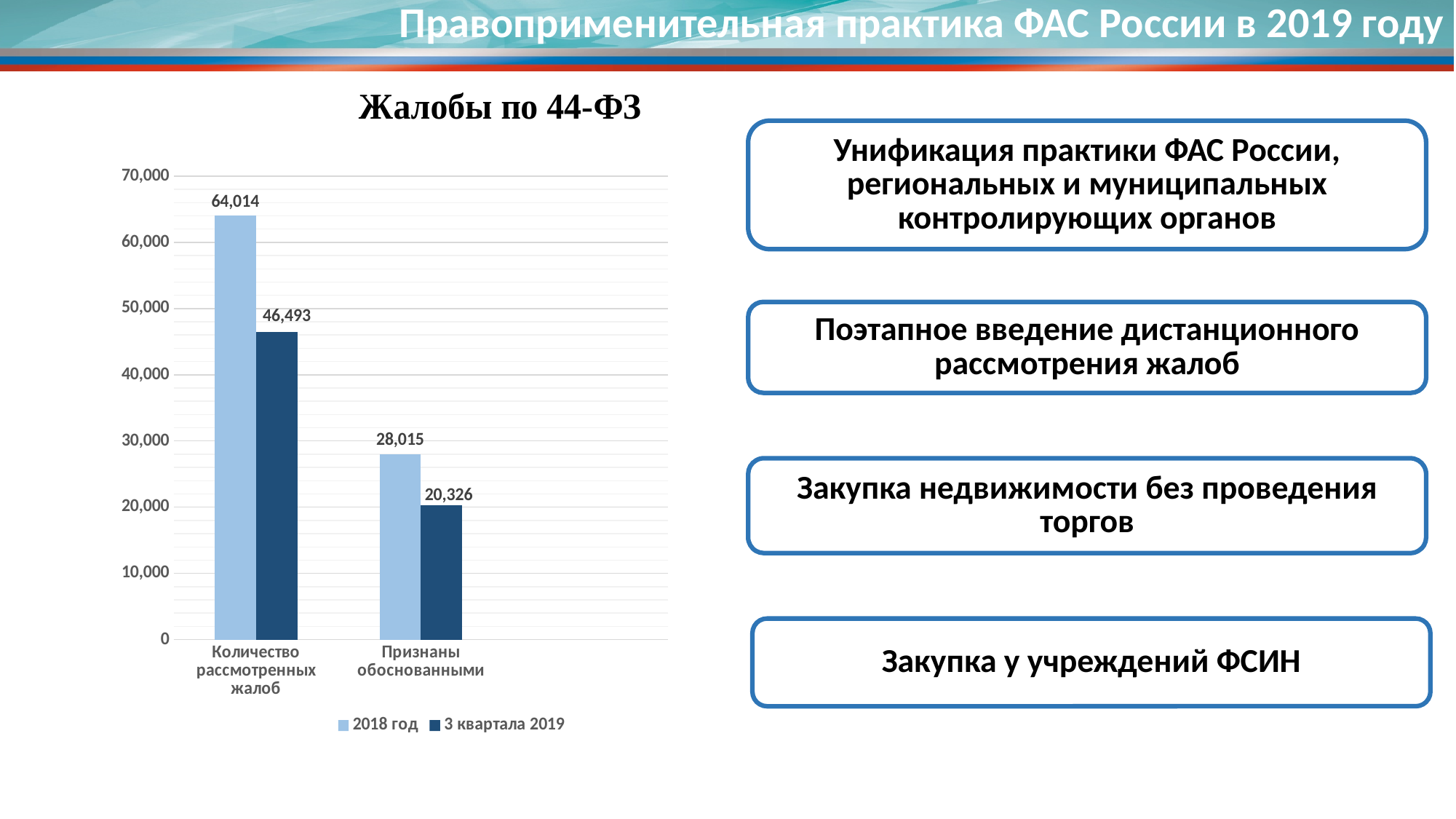
What is the title of the chart? Жалобы по 44-ФЗ What is the difference between the '2018 год' and '3 квартала 2019' values for 'Признаны обоснованными'? 7,689 How many categories are shown on the x axis of the chart? 2 What is the value for 'Количество рассмотренных жалоб' in the '2018 год' series? 64,014 Which bar has the highest value on the chart? Количество рассмотренных жалоб, 2018 год Which bar has the lowest value on the chart? Признаны обоснованными, 3 квартала 2019 Which is larger: the '3 квартала 2019' value for 'Количество рассмотренных жалоб' or the '2018 год' value for 'Признаны обоснованными'? 3 квартала 2019 value for Количество рассмотренных жалоб What is the value for 'Признаны обоснованными' in the '2018 год' series? 28,015 What is the difference between the '2018 год' and '3 квартала 2019' values for 'Количество рассмотренных жалоб'? 17,521 What is the value for 'Признаны обоснованными' in the '3 квартала 2019' series? 20,326 How many series does the chart legend list? 2 What is the value for 'Количество рассмотренных жалоб' in the '3 квартала 2019' series? 46,493